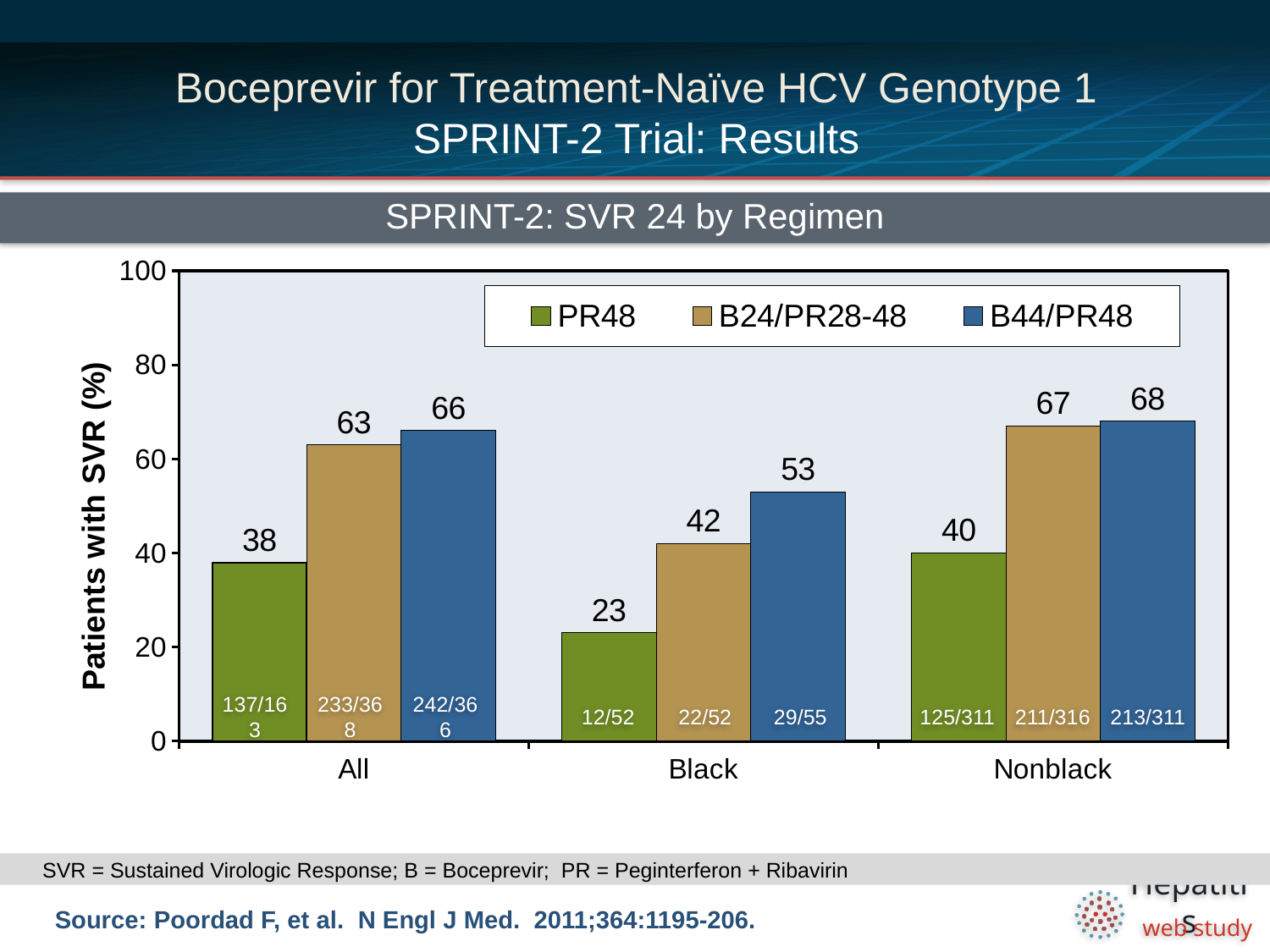
What kind of chart is shown on the slide? Bar chart Which is larger: the PR48 SVR rate in the Nonblack group or the B24/PR28-48 SVR rate in the Black group? B24/PR28-48 in the Black group Which patient group has the highest SVR rate for the B44/PR48 regimen? Nonblack How many patient groups are shown on the x axis? 3 Which regimen has the lowest SVR rate in the Black group? PR48 What is the difference in SVR rate between B44/PR48 and PR48 in the All group? 28 How many regimens does the legend list? 3 What is the difference in SVR rate between B24/PR28-48 and PR48 in the Black group? 19 What is the SVR rate for the B44/PR48 regimen in the Black group? 53 What is the title of the chart? SPRINT-2: SVR 24 by Regimen What is the SVR rate for the PR48 regimen in the All group? 38 What is the SVR rate for the B24/PR28-48 regimen in the Nonblack group? 67